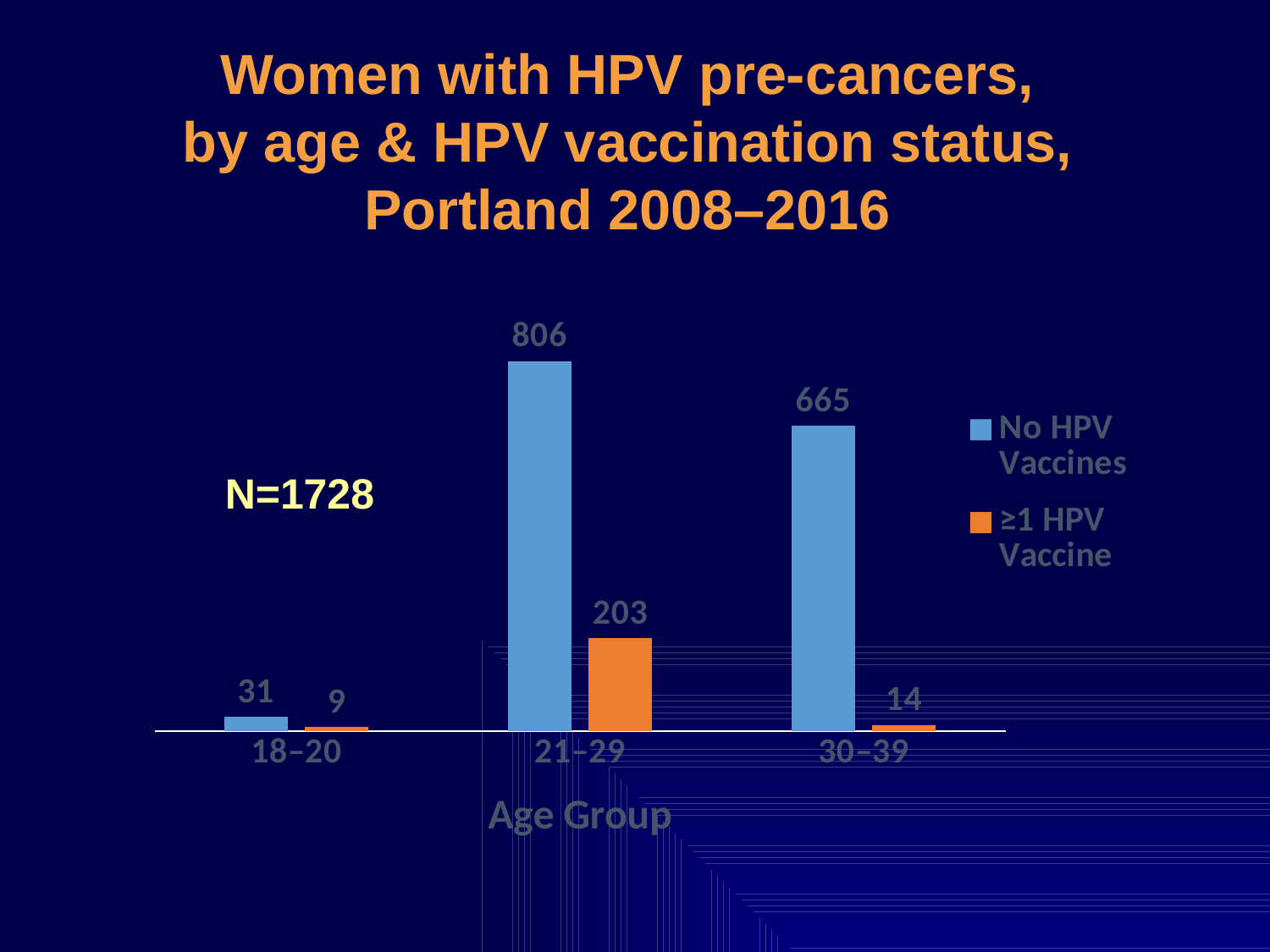
How many series does the legend list? 2 What is the value for No HPV Vaccines in the 21–29 age group? 806 Which age group has the highest value for ≥1 HPV Vaccine? 21–29 What is the value for No HPV Vaccines in the 18–20 age group? 31 Which is larger: the ≥1 HPV Vaccine value for 18–20 or for 30–39? 30–39 What is the value for ≥1 HPV Vaccine in the 30–39 age group? 14 What is the x-axis title of the chart? Age Group Which age group has the lowest value for No HPV Vaccines? 18–20 What total sample size (N) is stated on the slide? N=1728 How many age groups are shown on the x axis? 3 What is the difference between the No HPV Vaccines values for the 21–29 and 30–39 age groups? 141 What kind of chart is shown on the slide? Bar chart